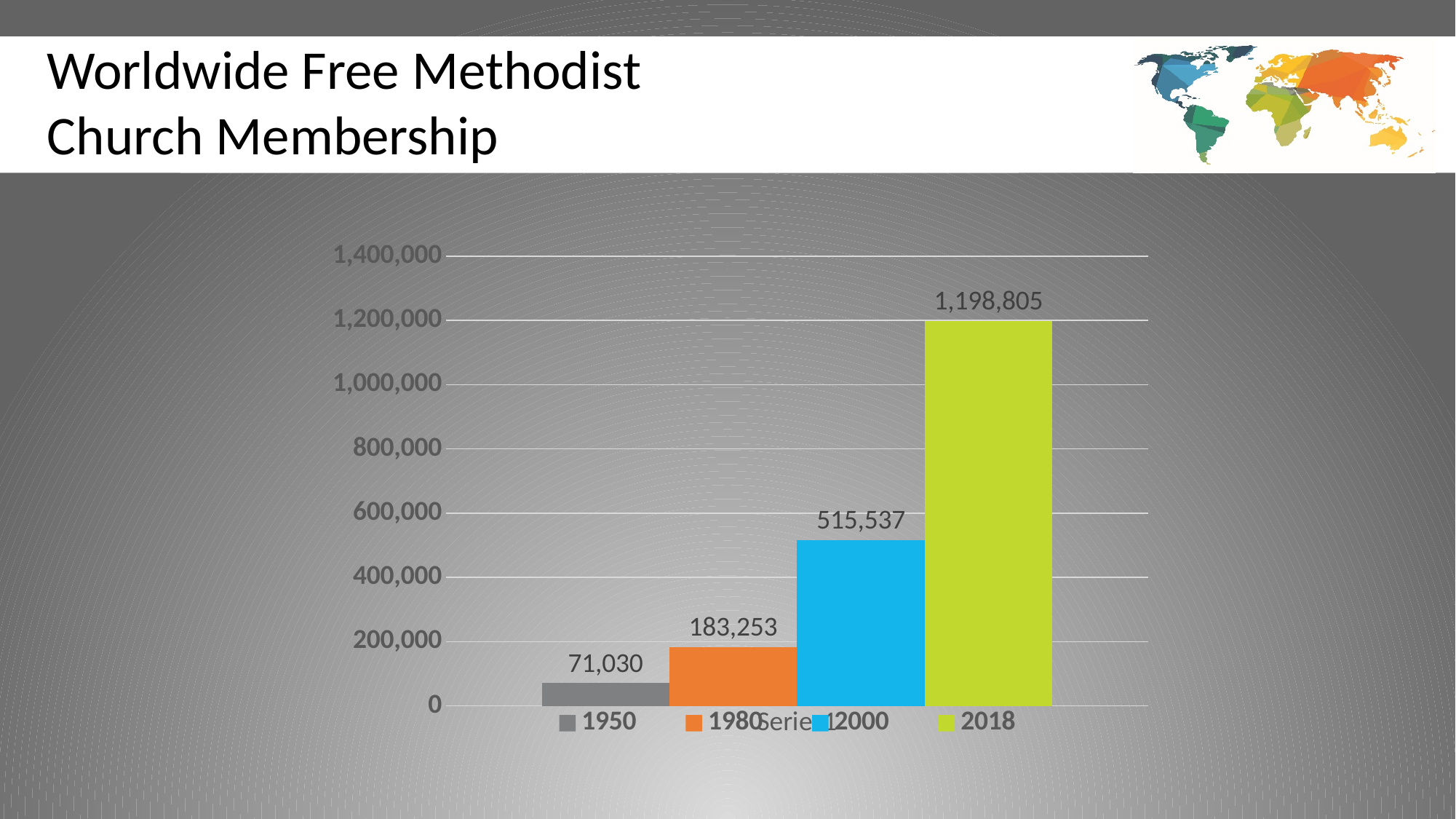
Which is larger, the membership for 2000 or for 1980? 2000 What is the difference between the 2018 and 2000 membership values? 683,268 Which year has the highest membership? 2018 What is the membership value shown for 1950? 71,030 What is the difference between the 1980 and 1950 membership values? 112,223 How many bars are plotted in the chart? 4 What is the membership value shown for 2000? 515,537 What is the membership value shown for 1980? 183,253 Which year has the lowest membership? 1950 What kind of chart is shown on the slide? Bar chart What is the membership value shown for 2018? 1,198,805 Do the membership values rise or fall from 1950 to 2018? Rise